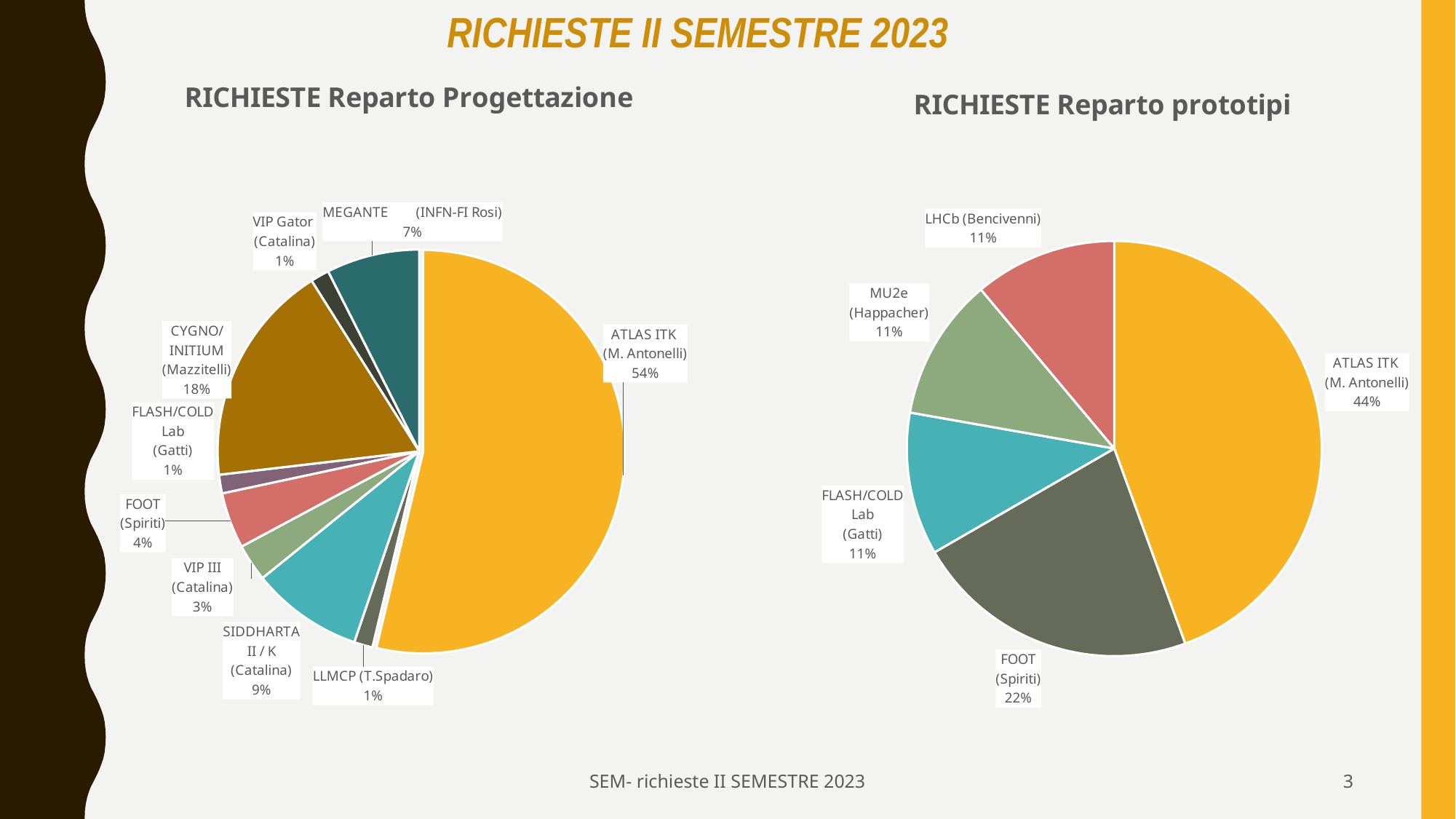
In the RICHIESTE Reparto Progettazione chart, what percentage is shown for SIDDHARTA II / K (Catalina)? 9% In the RICHIESTE Reparto Progettazione chart, which category has the largest share? ATLAS ITK (M. Antonelli) In the RICHIESTE Reparto Progettazione chart, what is the difference in percentage points between CYGNO/INITIUM (Mazzitelli) and MEGANTE (INFN-FI Rosi)? 11 How many slices does the RICHIESTE Reparto prototipi chart have? 5 In the RICHIESTE Reparto prototipi chart, what percentage is shown for MU2e (Happacher)? 11% In the RICHIESTE Reparto Progettazione chart, what share does ATLAS ITK (M. Antonelli) have? 54% In the RICHIESTE Reparto Progettazione chart, which is larger: FOOT (Spiriti) or VIP III (Catalina)? FOOT (Spiriti) In the RICHIESTE Reparto Progettazione chart, what percentage is shown for CYGNO/INITIUM (Mazzitelli)? 18% In the RICHIESTE Reparto prototipi chart, what share does FOOT (Spiriti) have? 22% In the RICHIESTE Reparto prototipi chart, what is the difference in percentage points between ATLAS ITK (M. Antonelli) and FOOT (Spiriti)? 22 How many slices does the RICHIESTE Reparto Progettazione chart have? 9 What type of chart is the RICHIESTE Reparto prototipi chart? Pie chart